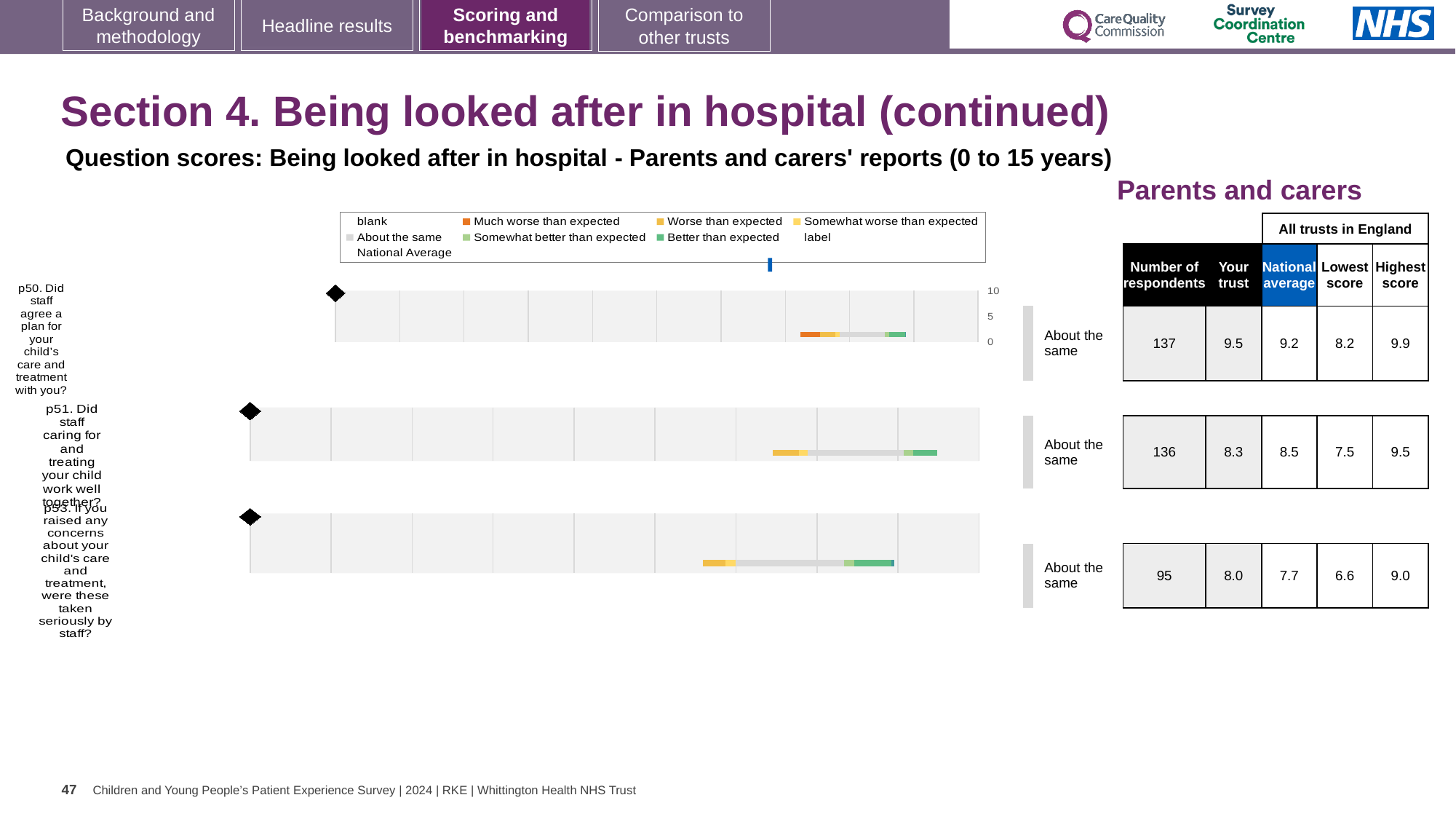
What is the lowest score among all trusts in England for question p53? 6.6 What is the national average score for question p53 (If you raised any concerns about your child's care and treatment, were these taken seriously by staff?)? 7.7 How many survey questions are plotted on this slide? 3 What kind of chart is used to show the benchmarking results for each question? Bar chart Which of the three questions shown has the lowest number of respondents? p53 For question p51, what is the difference between the national average and the 'Your trust' score? 0.2 What benchmark category is shown beside the chart for question p51? About the same In the table next to the charts, how many respondents are listed for question p50 (Did staff agree a plan for your child's care and treatment with you?)? 137 For question p53, which is larger: the 'Your trust' score or the national average? Your trust Which of the three questions shown has the highest 'Your trust' score? p50 What is the 'Your trust' score for question p51 (Did staff caring for and treating your child work well together?)? 8.3 What is the highest score among all trusts in England for question p50? 9.9